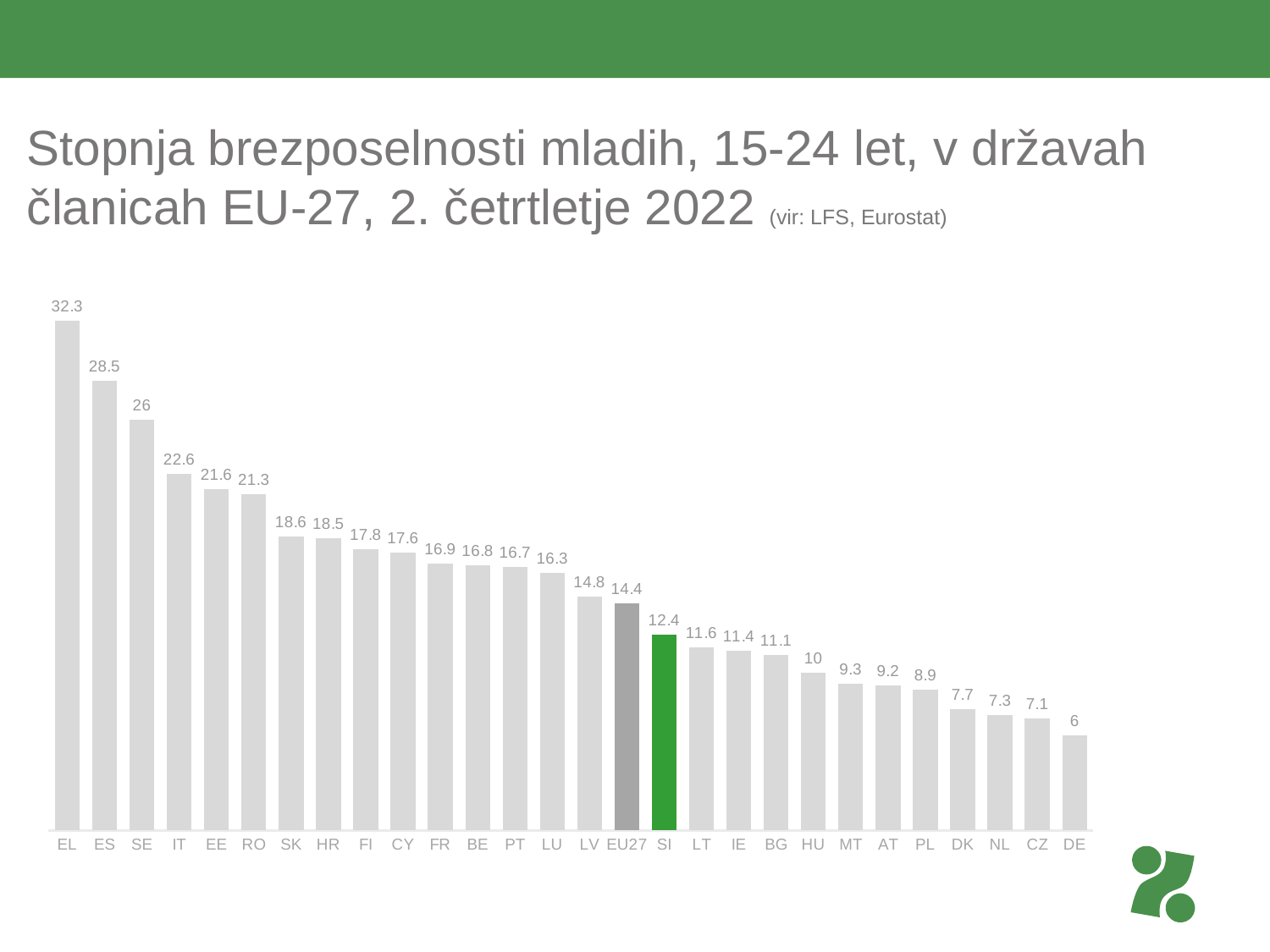
How many bars are shown on the chart? 28 What kind of chart is shown on the slide? Bar chart What value is shown for HU? 10 Which country has the highest value on the chart? EL What is the youth unemployment rate shown for SI? 12.4 Which country has the lowest value on the chart? DE Which has a larger value, IT or SK? IT Do the values rise or fall from left to right along the x axis? Fall What is the difference between the values for EL and ES? 3.8 What value is shown for EU27? 14.4 What is the difference between the values for EU27 and SI? 2 Which bar is coloured green on the chart? SI